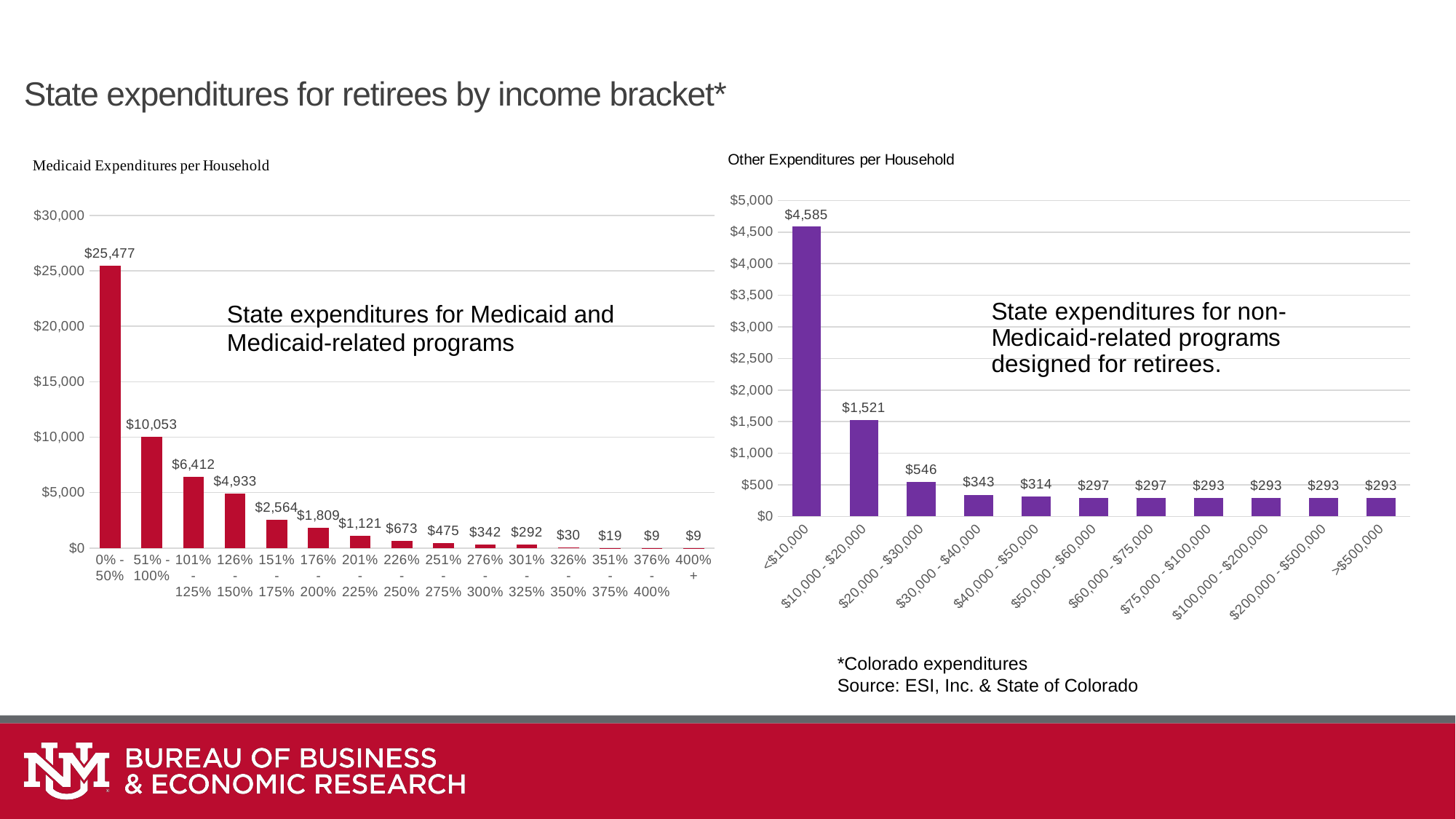
In the Other Expenditures per Household chart, what is the difference between the <$10,000 bracket and the $20,000 - $30,000 bracket? $4,039 In the Other Expenditures per Household chart, what is the value for the $30,000 - $40,000 bracket? $343 In the Medicaid Expenditures per Household chart, what is the value for the 0% - 50% income bracket? $25,477 In the Medicaid Expenditures per Household chart, what is the value for the 151% - 175% bracket? $2,564 In the Other Expenditures per Household chart, how many income brackets are shown? 11 In the Other Expenditures per Household chart, which income bracket has the highest expenditure? <$10,000 In the Medicaid Expenditures per Household chart, do the values rise or fall as income bracket increases along the x axis? fall In the Medicaid Expenditures per Household chart, which income bracket has the highest expenditure? 0% - 50% In the Medicaid Expenditures per Household chart, what is the difference between the 0% - 50% bracket and the 51% - 100% bracket? $15,424 In the Medicaid Expenditures per Household chart, how many income brackets are shown? 15 In the Other Expenditures per Household chart, what is the value for the $10,000 - $20,000 bracket? $1,521 What type of chart is the Other Expenditures per Household chart? bar chart